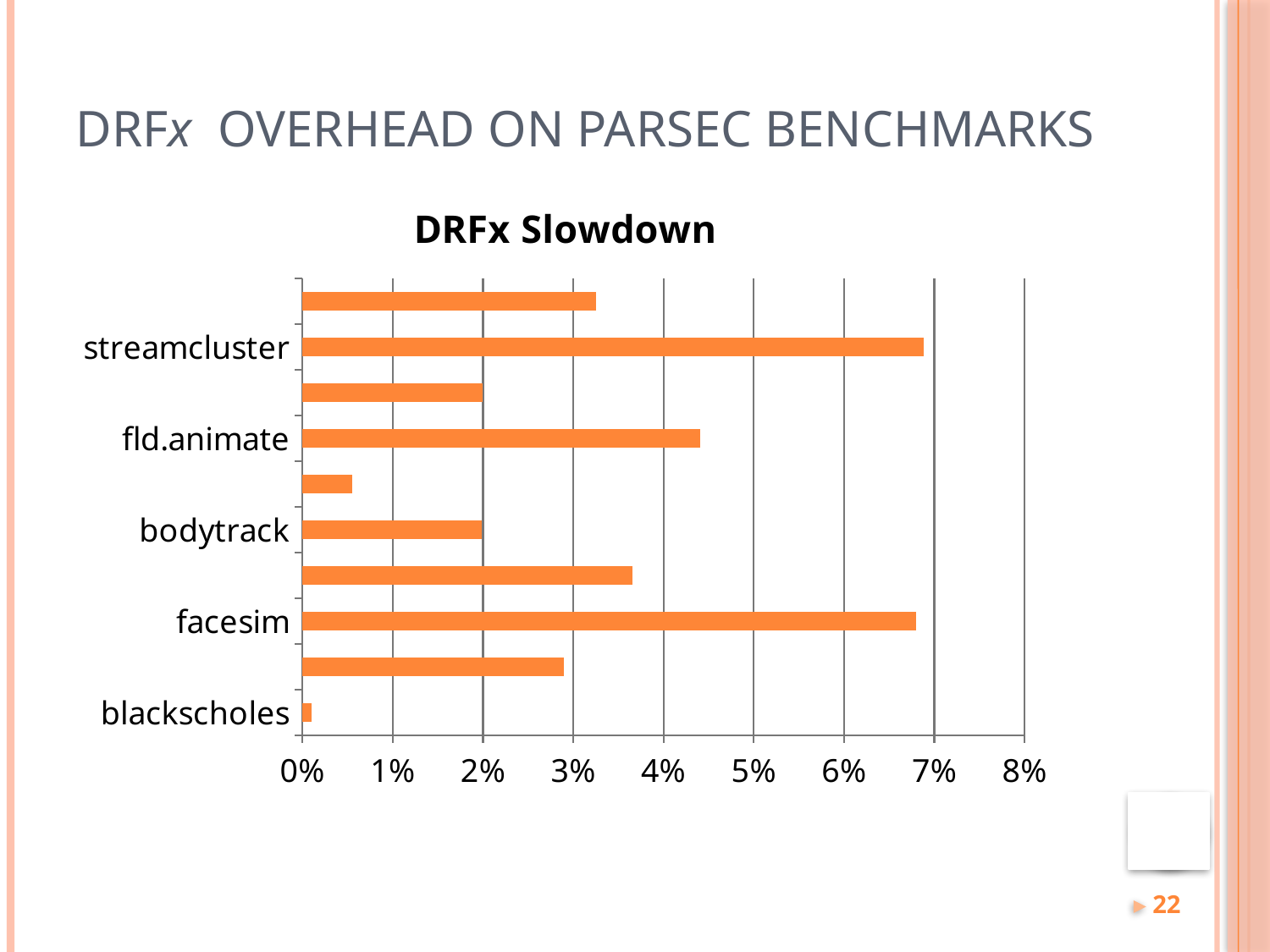
What is the highest value shown on the horizontal axis? 8% Is the DRFx slowdown for streamcluster greater or less than 6%? greater Is the DRFx slowdown for bodytrack greater or less than 3%? less Which labeled benchmark has the lowest DRFx slowdown? blackscholes Which has a larger DRFx slowdown, facesim or bodytrack? facesim Is the DRFx slowdown for facesim greater or less than 6%? greater Which has a larger DRFx slowdown, streamcluster or fld.animate? streamcluster What kind of chart is shown on the slide? bar chart How many bars are plotted in the chart? 10 What is the title of the chart? DRFx Slowdown